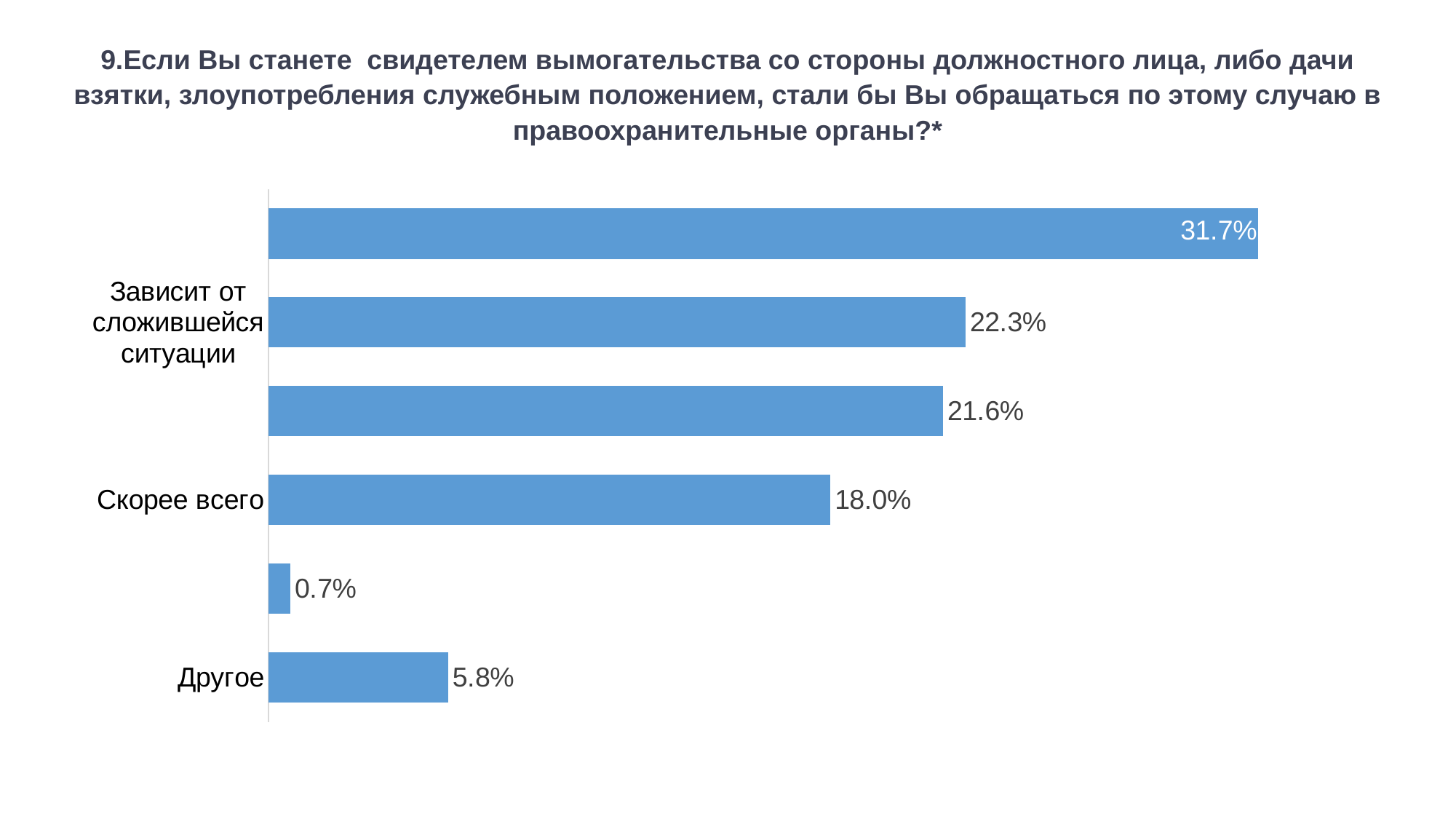
What is the difference between the values for "Зависит от сложившейся ситуации" and "Скорее всего"? 4.3% What is the value for "Зависит от сложившейся ситуации"? 22.3% What is the value for "Другое"? 5.8% What colour are the bars on the chart? Blue What question number is given at the start of the chart title? 9 What is the largest value shown on the chart? 31.7% What is the difference between the values for "Скорее всего" and "Другое"? 12.2% How many bars are shown on the chart? 6 What kind of chart is shown on the slide? Bar chart Which is larger, the value for "Скорее всего" or the value for "Другое"? Скорее всего What is the smallest value shown on the chart? 0.7% What is the value for "Скорее всего"? 18.0%